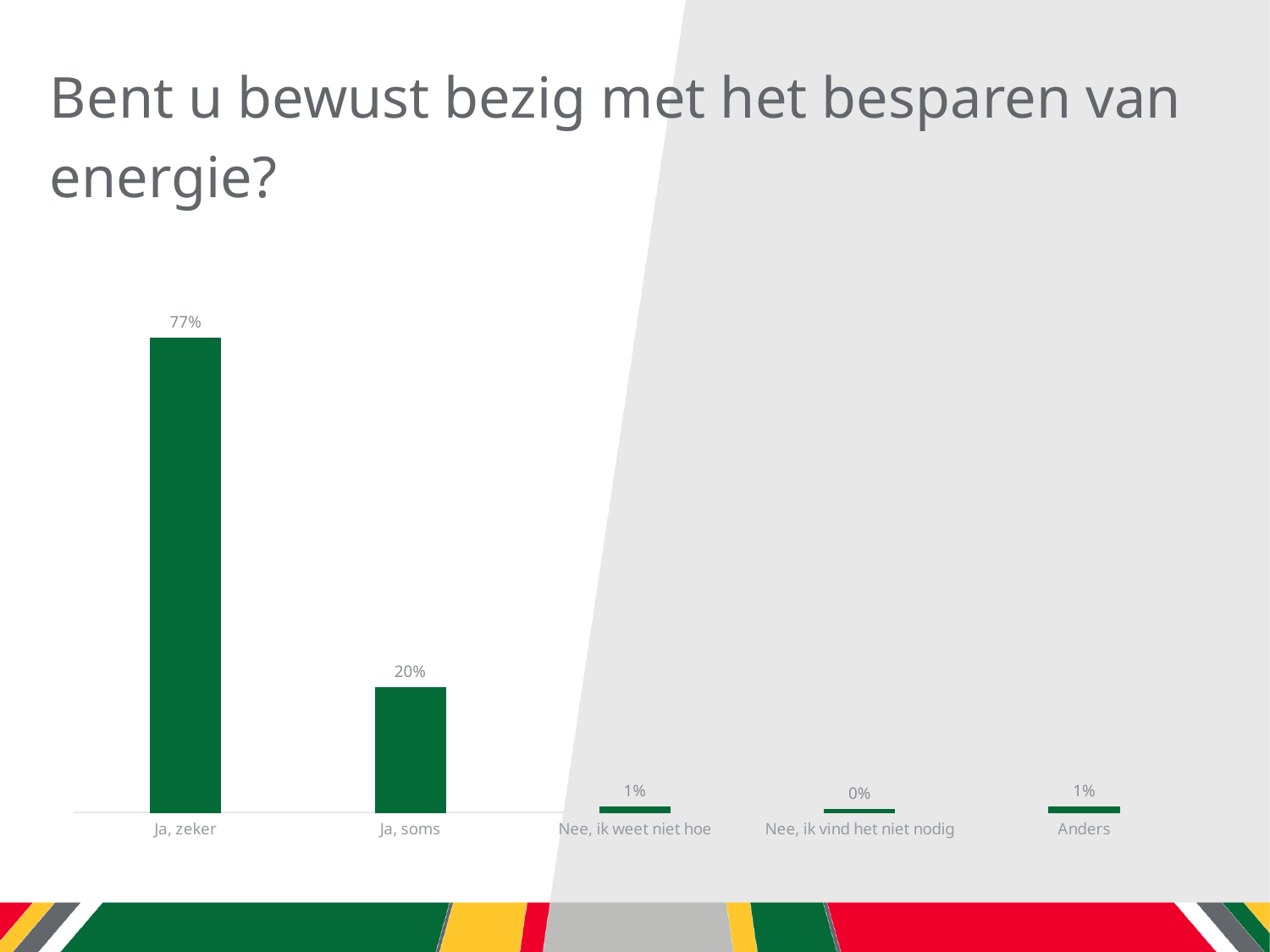
What is the value for "Ja, soms"? 20% How many categories are shown on the x axis? 5 What kind of chart is shown on the slide? Bar chart What is the value for "Nee, ik vind het niet nodig"? 0% Which category has the lowest value? Nee, ik vind het niet nodig Which is larger, the value for "Ja, soms" or the value for "Anders"? Ja, soms What is the title of the slide above the chart? Bent u bewust bezig met het besparen van energie? What is the value for "Anders"? 1% What is the difference between the values for "Ja, zeker" and "Ja, soms"? 57% What is the value for "Nee, ik weet niet hoe"? 1% Which category has the highest value? Ja, zeker What is the value for "Ja, zeker"? 77%